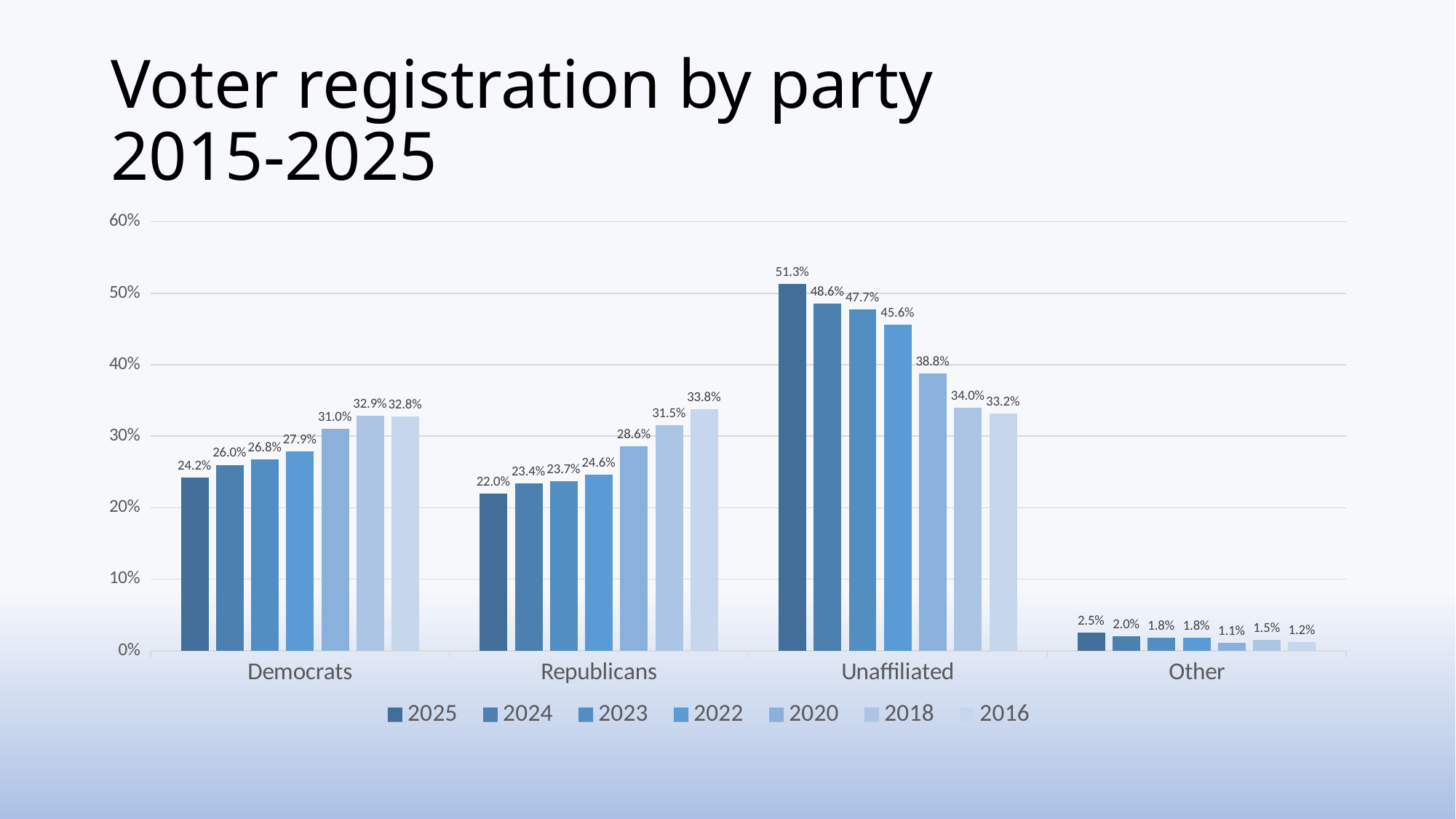
Which category has the lowest value in 2018? Other What is the value for Unaffiliated in 2016? 33.2% What is the title of the slide? Voter registration by party 2015-2025 How many series does the legend list? 7 What kind of chart is shown on the slide? bar chart What is the value for Republicans in 2020? 28.6% Is the value for Unaffiliated in 2024 greater or less than 40%? greater What is the difference between the Unaffiliated values for 2025 and 2016? 18.1% How many categories are shown on the x axis? 4 Which is larger, the Democrats value in 2016 or the Republicans value in 2016? Republicans Which category has the highest value in 2025? Unaffiliated What is the value for Democrats in 2025? 24.2%